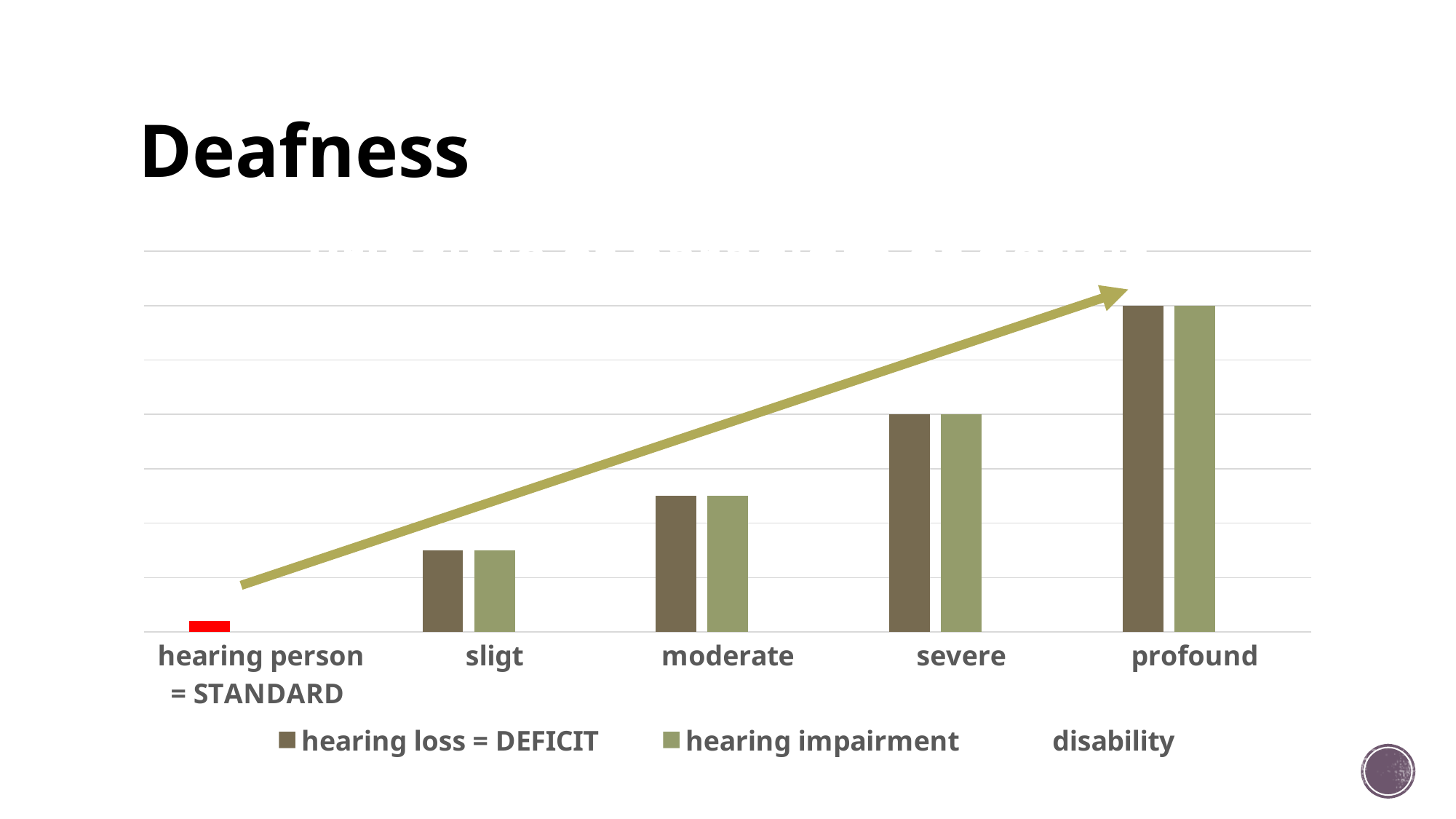
What is the title of the slide containing the chart? Deafness What is the first series listed in the chart's legend? hearing loss = DEFICIT Which category has a larger value for hearing loss = DEFICIT, severe or moderate? severe Which category has a larger value for hearing impairment, sligt or profound? profound Do the bar values rise or fall moving from left to right along the x axis? rise What kind of chart is shown on the slide? bar chart How many series does the chart's legend list? 3 How many categories are shown along the x axis of the chart? 5 Which category has the tallest bars in the chart? profound Which category has the lowest bar in the chart? hearing person = STANDARD